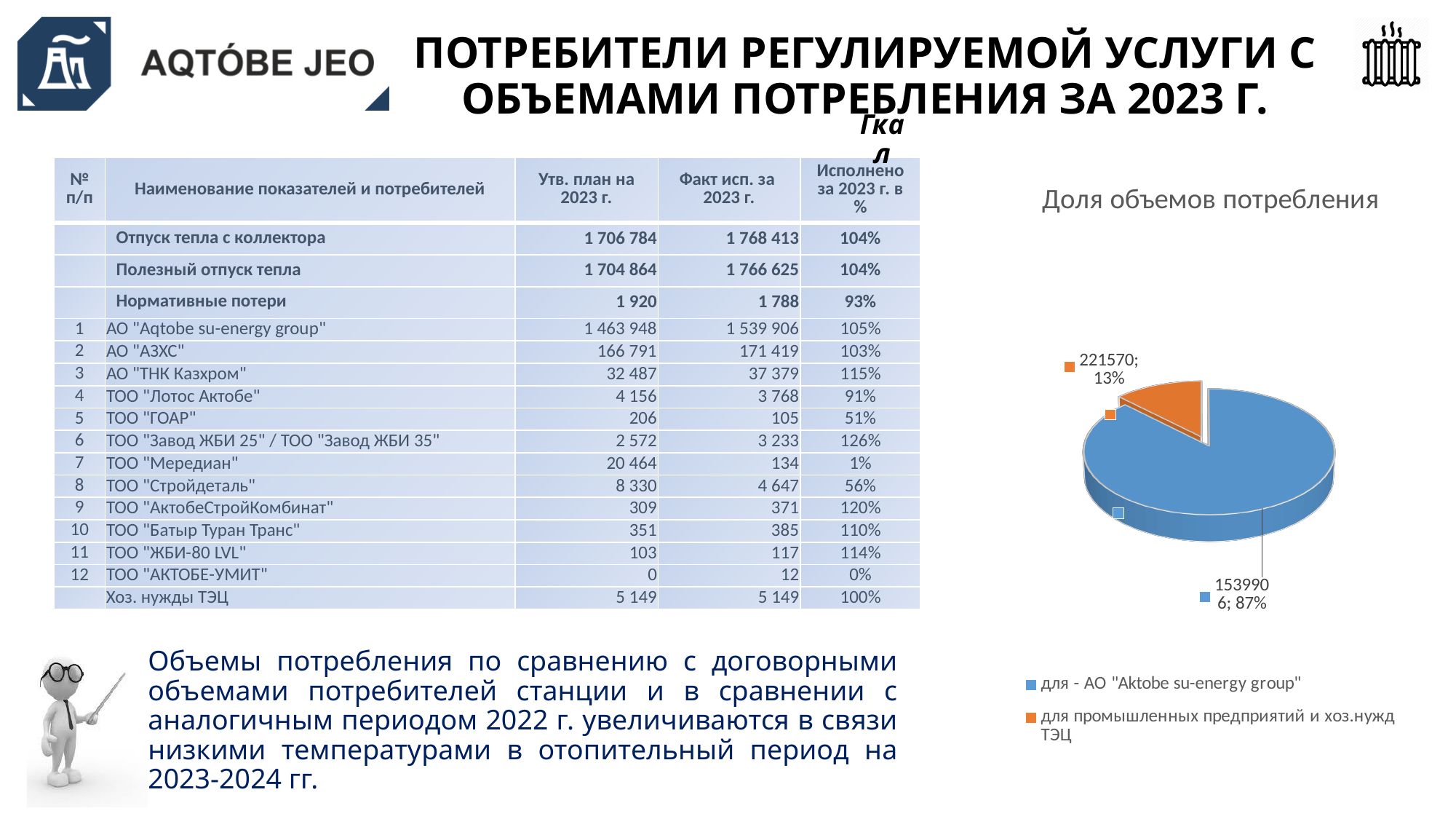
In the pie chart "Доля объемов потребления", which is larger: the share for АО "Aktobe su-energy group" or the share for промышленных предприятий и хоз.нужд ТЭЦ? АО "Aktobe su-energy group" How many slices does the pie chart "Доля объемов потребления" have? 2 In the pie chart "Доля объемов потребления", which slice is the largest? для - АО "Aktobe su-energy group" What kind of chart is shown under the title "Доля объемов потребления"? pie chart In the pie chart "Доля объемов потребления", what share is shown for the slice "для промышленных предприятий и хоз.нужд ТЭЦ"? 13% In the pie chart "Доля объемов потребления", what value is labelled on the blue slice? 1539906 How many entries does the legend of the pie chart "Доля объемов потребления" list? 2 In the pie chart "Доля объемов потребления", what colour is the slice for "для промышленных предприятий и хоз.нужд ТЭЦ"? orange In the pie chart "Доля объемов потребления", what value is labelled on the orange slice? 221570 What is the title of the pie chart on the right of the slide? Доля объемов потребления In the pie chart "Доля объемов потребления", what share is shown for the slice "для - АО "Aktobe su-energy group""? 87% In the pie chart "Доля объемов потребления", which slice is the smallest? для промышленных предприятий и хоз.нужд ТЭЦ